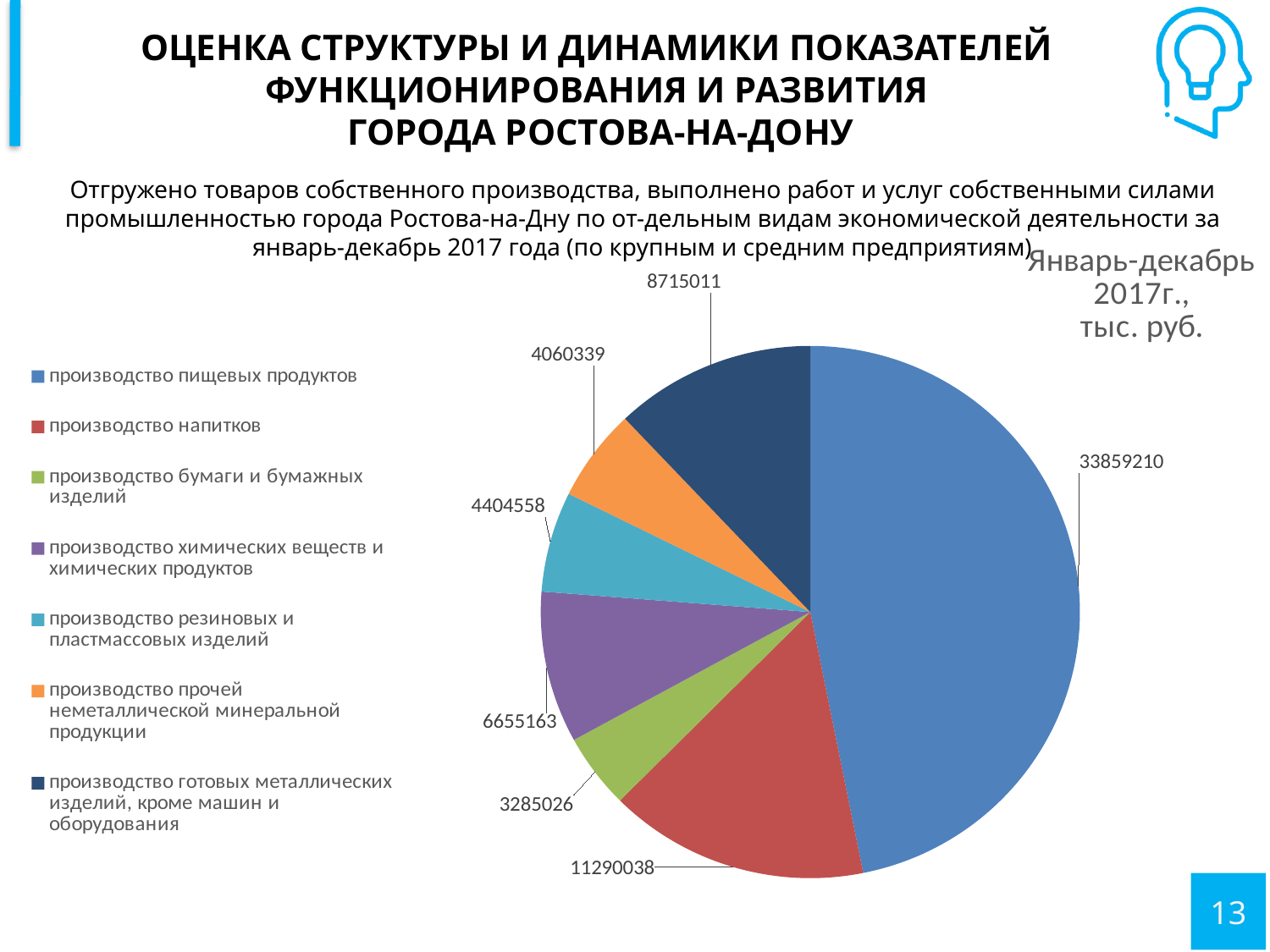
What is the value for производство напитков? 11290038 What is the value for производство пищевых продуктов? 33859210 What kind of chart is shown on the slide? pie chart What is the value for производство готовых металлических изделий, кроме машин и оборудования? 8715011 What is the value for производство химических веществ и химических продуктов? 6655163 Which category has the largest slice of the pie? производство пищевых продуктов How many entries does the legend of the pie chart list? 7 Which category has the smallest slice of the pie? производство бумаги и бумажных изделий What is the title of the pie chart? Январь-декабрь 2017г., тыс. руб. How many slices does the pie chart have? 7 Which is larger: производство резиновых и пластмассовых изделий or производство прочей неметаллической минеральной продукции? производство резиновых и пластмассовых изделий What is the difference between the values for производство пищевых продуктов and производство напитков? 22569172